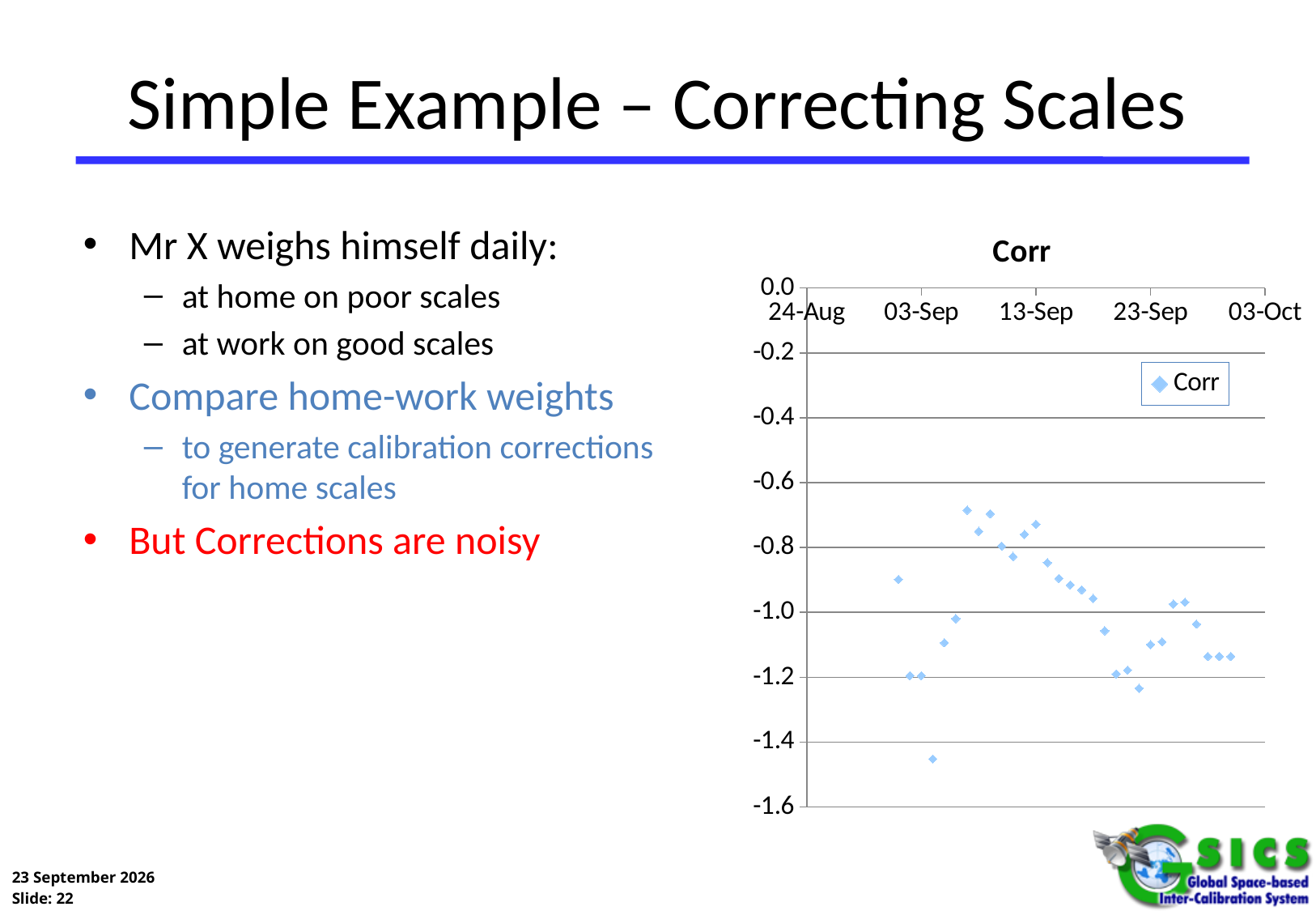
What is the name of the series shown in the chart legend? Corr What kind of chart is shown on the slide? scatter chart What is the title of the chart? Corr What is the lowest value shown on the chart's vertical axis? -1.6 How many series does the chart legend list? 1 Is the lowest plotted value in the chart greater or less than -1.4? less Is the leftmost plotted point in the chart greater or less than -1.0? greater Are all plotted points in the chart greater or less than -0.2? less